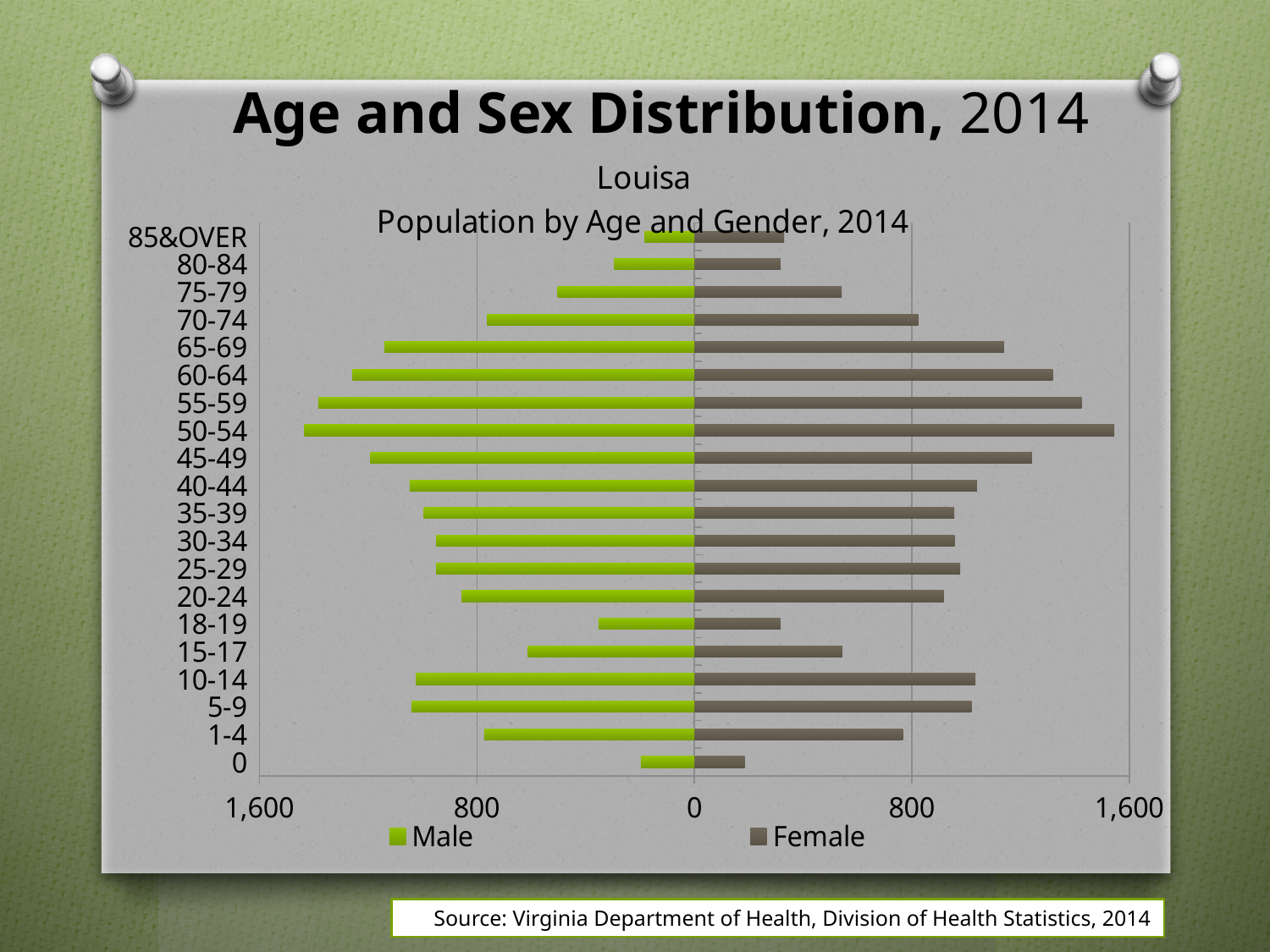
What is the title of the chart? Louisa Population by Age and Gender, 2014 Which is larger, the Male value for 55-59 or the Male value for 18-19? 55-59 Is the Male value for the 18-19 age group greater or less than 800? less How many series does the legend list? 2 Is the Male value for the 65-69 age group greater or less than 800? greater Which age group has the longest Female bar? 50-54 Is the Female value for the 50-54 age group greater or less than 800? greater How many age groups are shown on the chart? 20 Which age group has the shortest Female bar? 0 Which age group has the longest Male bar? 50-54 What kind of chart is shown on the slide? bar chart